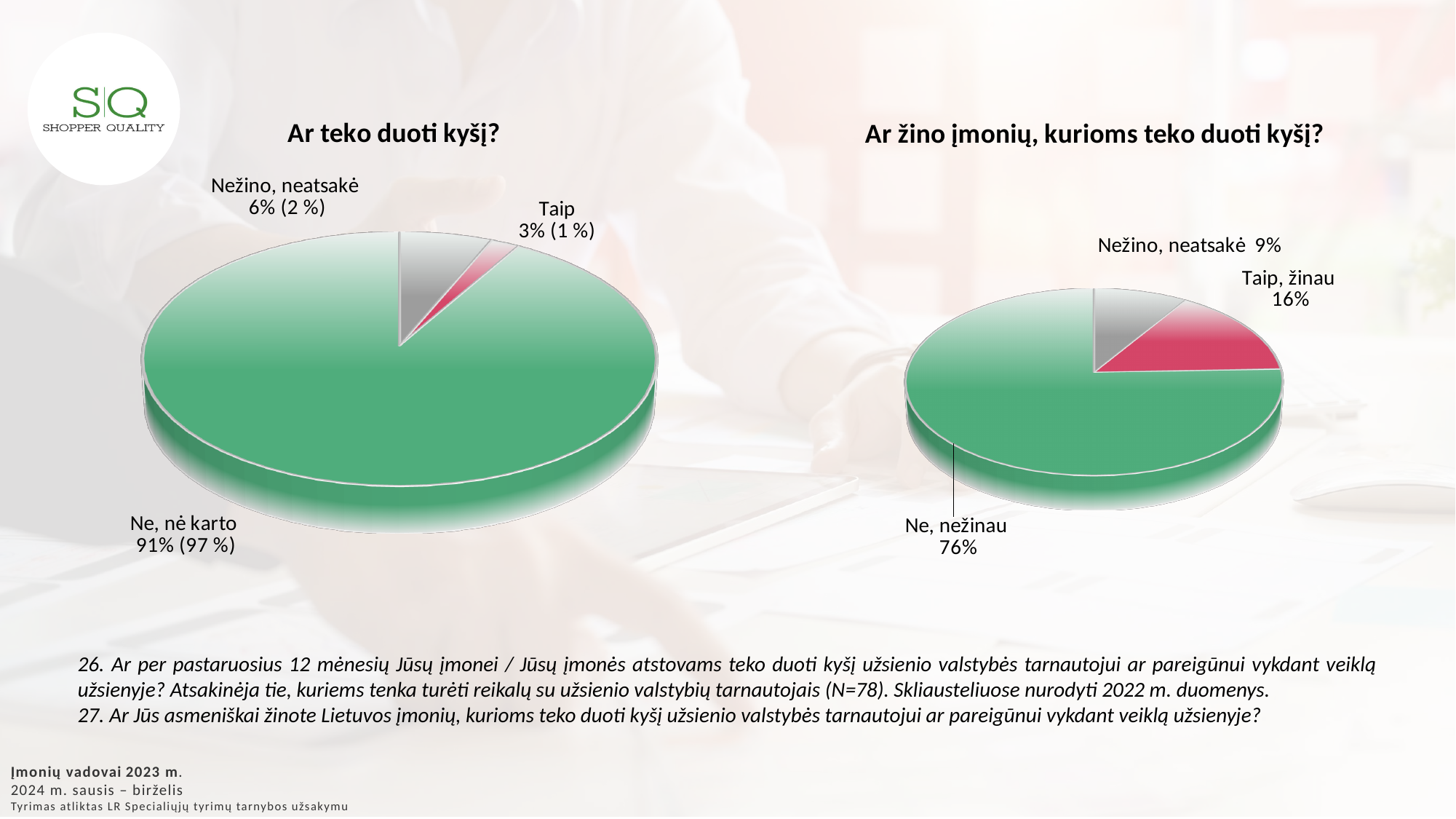
In the chart titled "Ar žino įmonių, kurioms teko duoti kyšį?", what is the difference in percentage points between "Ne, nežinau" and "Taip, žinau"? 60 In the chart titled "Ar žino įmonių, kurioms teko duoti kyšį?", what share is shown for "Taip, žinau"? 16% In the chart titled "Ar žino įmonių, kurioms teko duoti kyšį?", what share is shown for "Nežino, neatsakė"? 9% In the chart titled "Ar teko duoti kyšį?", what share is shown for "Taip"? 3% (1 %) What type of chart is the chart titled "Ar teko duoti kyšį?"? Pie chart How many slices does the chart titled "Ar žino įmonių, kurioms teko duoti kyšį?" have? 3 In the chart titled "Ar žino įmonių, kurioms teko duoti kyšį?", what share is shown for "Ne, nežinau"? 76% In the chart titled "Ar teko duoti kyšį?", which is larger, "Nežino, neatsakė" or "Taip"? Nežino, neatsakė In the chart titled "Ar žino įmonių, kurioms teko duoti kyšį?", which category has the smallest slice? Nežino, neatsakė In the chart titled "Ar teko duoti kyšį?", what share is shown for "Nežino, neatsakė"? 6% (2 %) In the chart titled "Ar teko duoti kyšį?", what share is shown for "Ne, nė karto"? 91% (97 %) In the chart titled "Ar teko duoti kyšį?", which category has the largest slice? Ne, nė karto